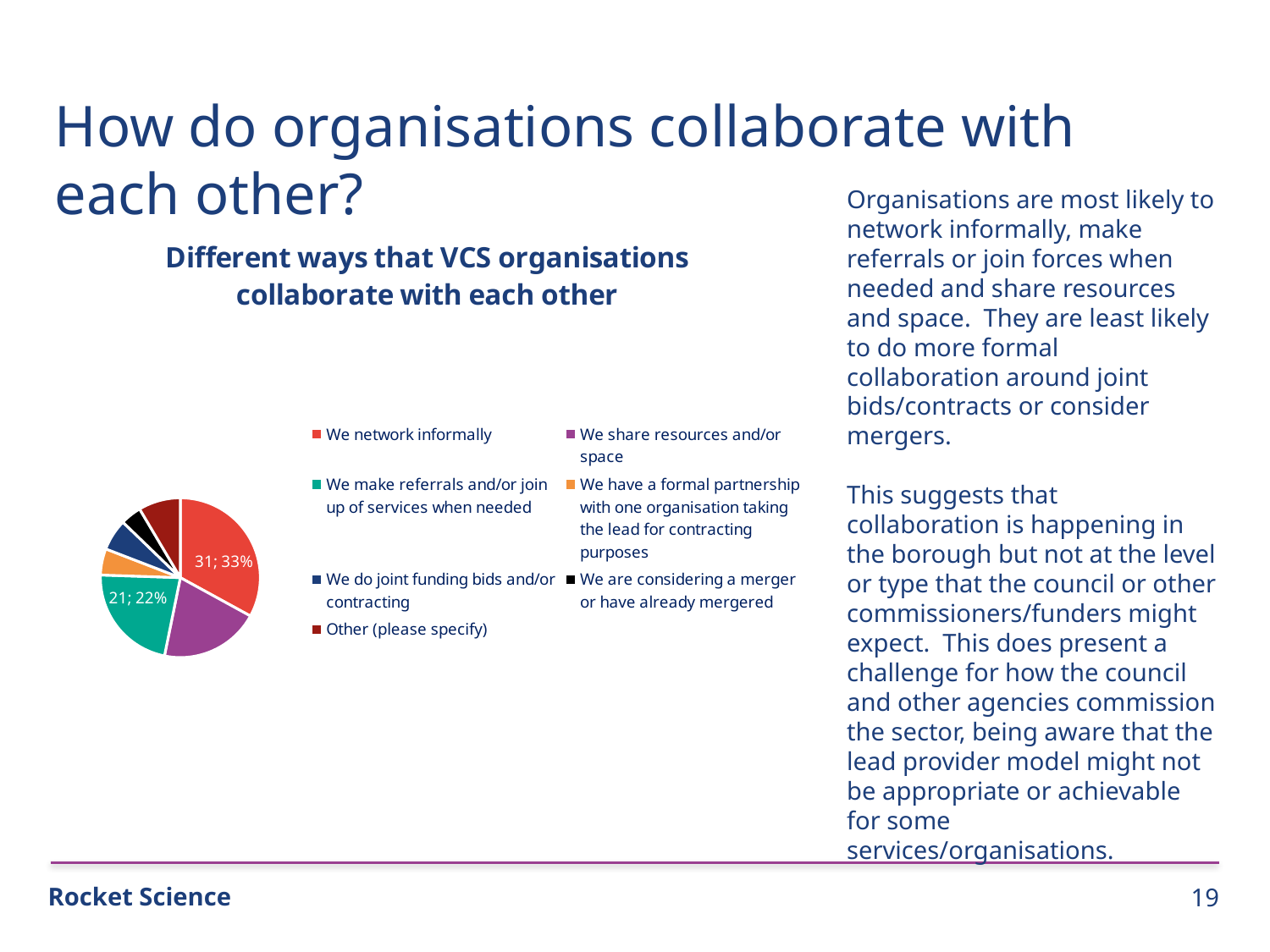
Which category has the largest slice of the pie? We network informally Which is larger: 'We network informally' or 'We make referrals and/or join up of services when needed'? We network informally What share of the pie does 'We network informally' represent? 33% What colour is the 'We network informally' slice? red What data label is shown for the 'We network informally' slice? 31; 33% How many categories does the legend list? 7 What is the title of the chart? Different ways that VCS organisations collaborate with each other How many organisations are counted in the 'We make referrals and/or join up of services when needed' slice? 21 What percentage share does 'We make referrals and/or join up of services when needed' have? 22% What is the difference in count between 'We network informally' (31) and 'We make referrals and/or join up of services when needed' (21)? 10 What kind of chart is shown on the slide? pie chart Which is larger: 'We network informally' or 'We share resources and/or space'? We network informally